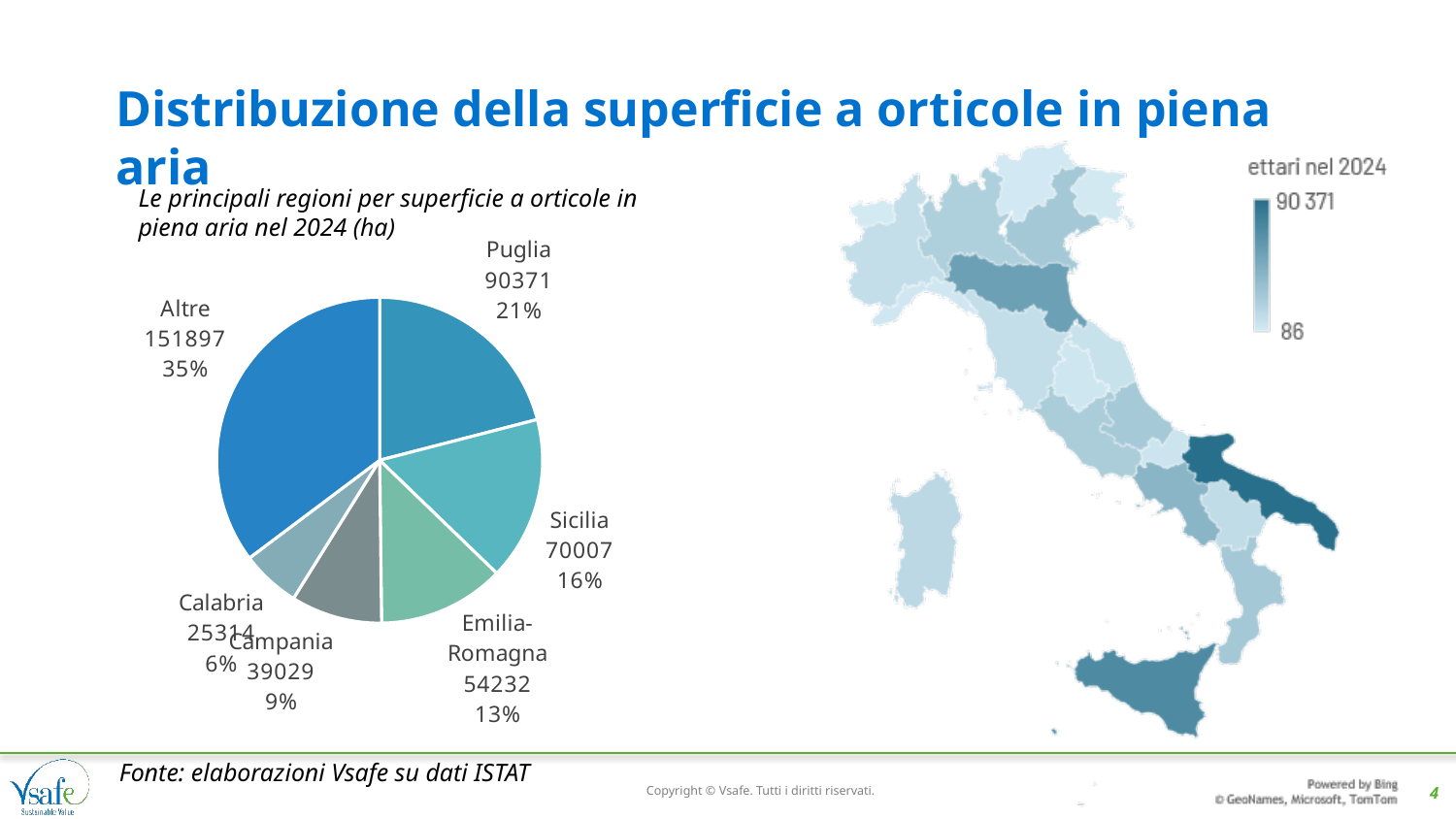
How many slices does the pie chart have? 6 In the map chart on the right, what is the maximum value shown on the colour legend? 90 371 In the pie chart, what is the surface area value shown for Puglia? 90371 In the pie chart, what percentage share is shown for Campania? 9% In the pie chart, what is the difference between the values for Puglia and Sicilia? 20364 In the pie chart, which is larger, the value for Campania or the value for Calabria? Campania In the pie chart, which single named region has the largest slice? Puglia In the pie chart, what percentage share is shown for Sicilia? 16% In the map chart on the right, what is the minimum value shown on the colour legend? 86 In the pie chart, what is the value shown for Emilia-Romagna? 54232 What type of chart is shown on the left of the slide? Pie chart In the pie chart, which slice has the smallest value? Calabria